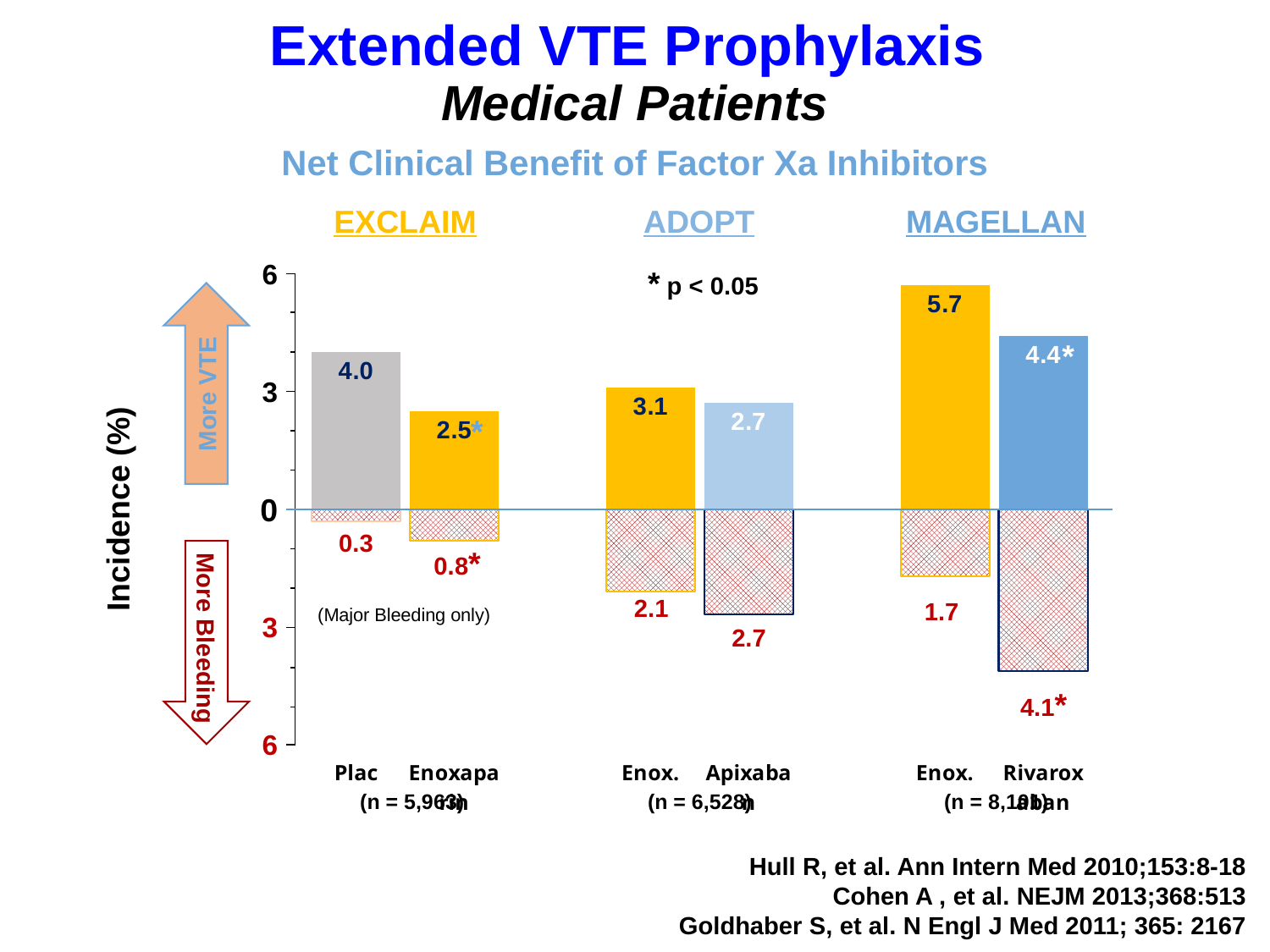
What is the VTE incidence for enoxaparin in the EXCLAIM trial? 2.5 Is the VTE incidence for rivaroxaban in the MAGELLAN trial greater or less than 3? greater What is the bleeding incidence for apixaban in the ADOPT trial? 2.7 What is the difference in VTE incidence between placebo and enoxaparin in the EXCLAIM trial? 1.5 What kind of chart is shown on the slide? Bar chart In the MAGELLAN trial, which has the higher bleeding incidence, enoxaparin or rivaroxaban? Rivaroxaban What is the VTE incidence for enoxaparin in the MAGELLAN trial? 5.7 Which bar has the lowest bleeding incidence across all three trials? Placebo in EXCLAIM (0.3) What is the bleeding incidence for rivaroxaban in the MAGELLAN trial? 4.1 How many trials are shown on the chart? 3 Which bar has the highest VTE incidence across all three trials? Enoxaparin in MAGELLAN (5.7) What is the VTE incidence for placebo in the EXCLAIM trial? 4.0